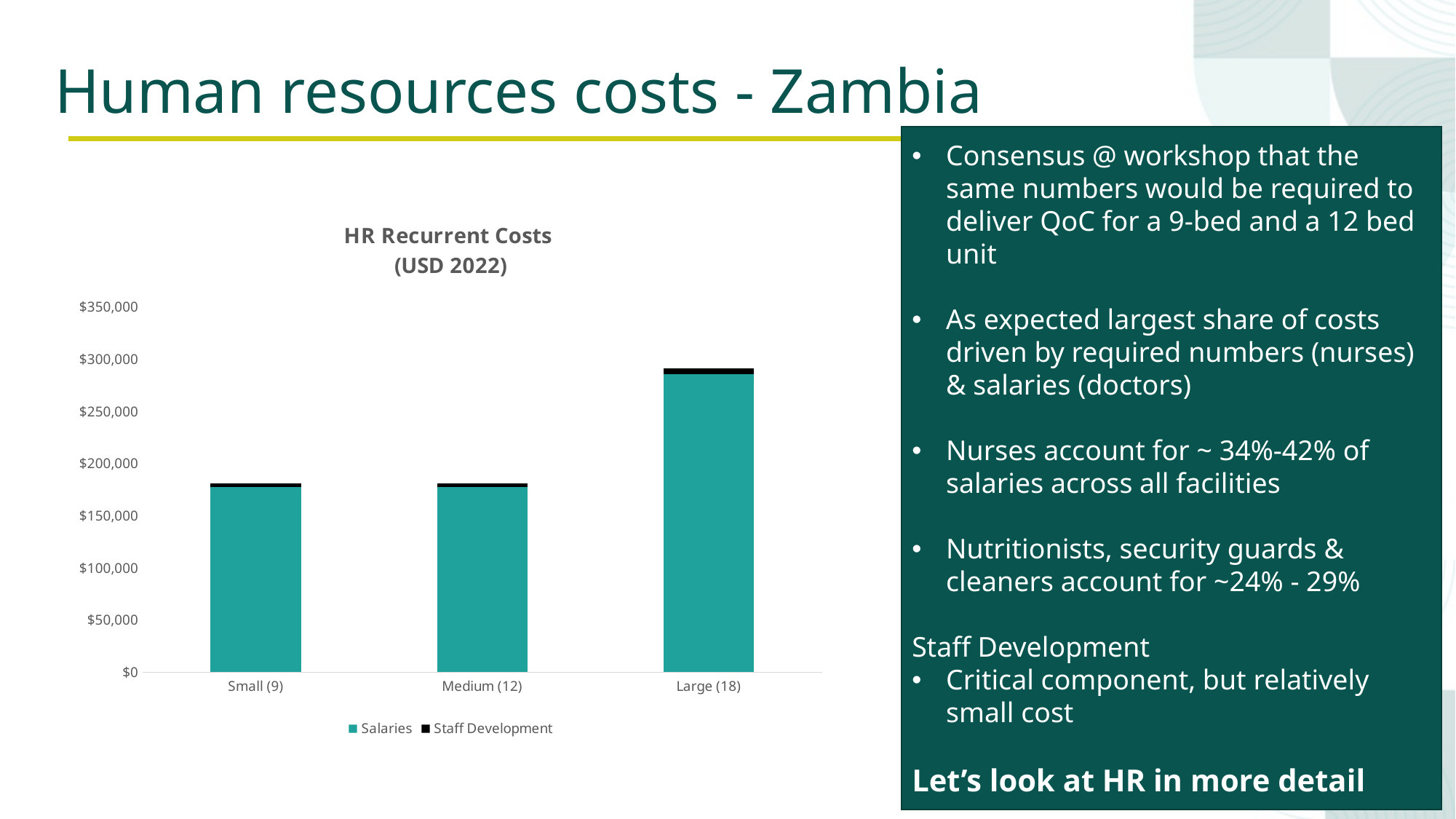
Which series makes up the larger part of each bar, Salaries or Staff Development? Salaries Which has a larger total HR recurrent cost, Small (9) or Large (18)? Large (18) Is the total HR recurrent cost for Medium (12) greater or less than $150,000? greater Which facility size has the highest total HR recurrent cost? Large (18) Which series are listed in the chart legend? Salaries and Staff Development How many facility size categories are shown on the x axis? 3 Is the total HR recurrent cost for Small (9) greater or less than $200,000? less Is the total HR recurrent cost for Large (18) greater or less than $300,000? less What is the title of the chart? HR Recurrent Costs (USD 2022) How many series does the chart legend list? 2 What kind of chart is shown on the slide? bar chart